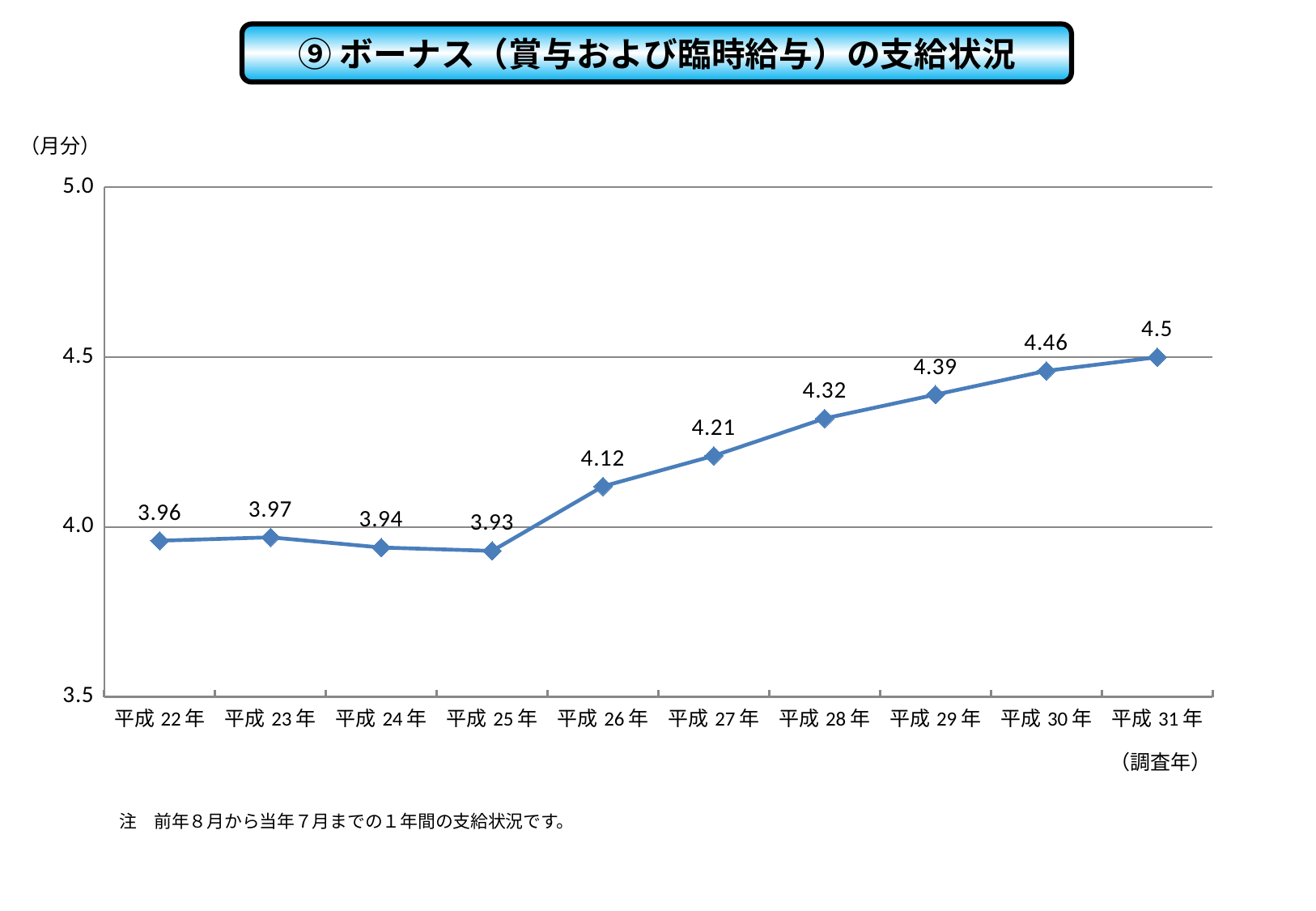
Is the value for 平成 29 年 greater or less than 4.0? greater What is the bonus value (in months) for 平成 26 年? 4.12 Which survey year has the lowest bonus value? 平成 25 年 Do the bonus values rise or fall from 平成 25 年 to 平成 31 年? rise Which survey year has the highest bonus value? 平成 31 年 What is the bonus value (in months) for 平成 31 年? 4.5 What is the difference between the bonus values for 平成 28 年 and 平成 27 年? 0.11 What is the bonus value (in months) for 平成 22 年? 3.96 How many survey years are plotted on the chart? 10 What kind of chart is shown on the slide? line chart Which is larger, the bonus value for 平成 23 年 or for 平成 24 年? 平成 23 年 What is the difference between the bonus values for 平成 31 年 and 平成 22 年? 0.54